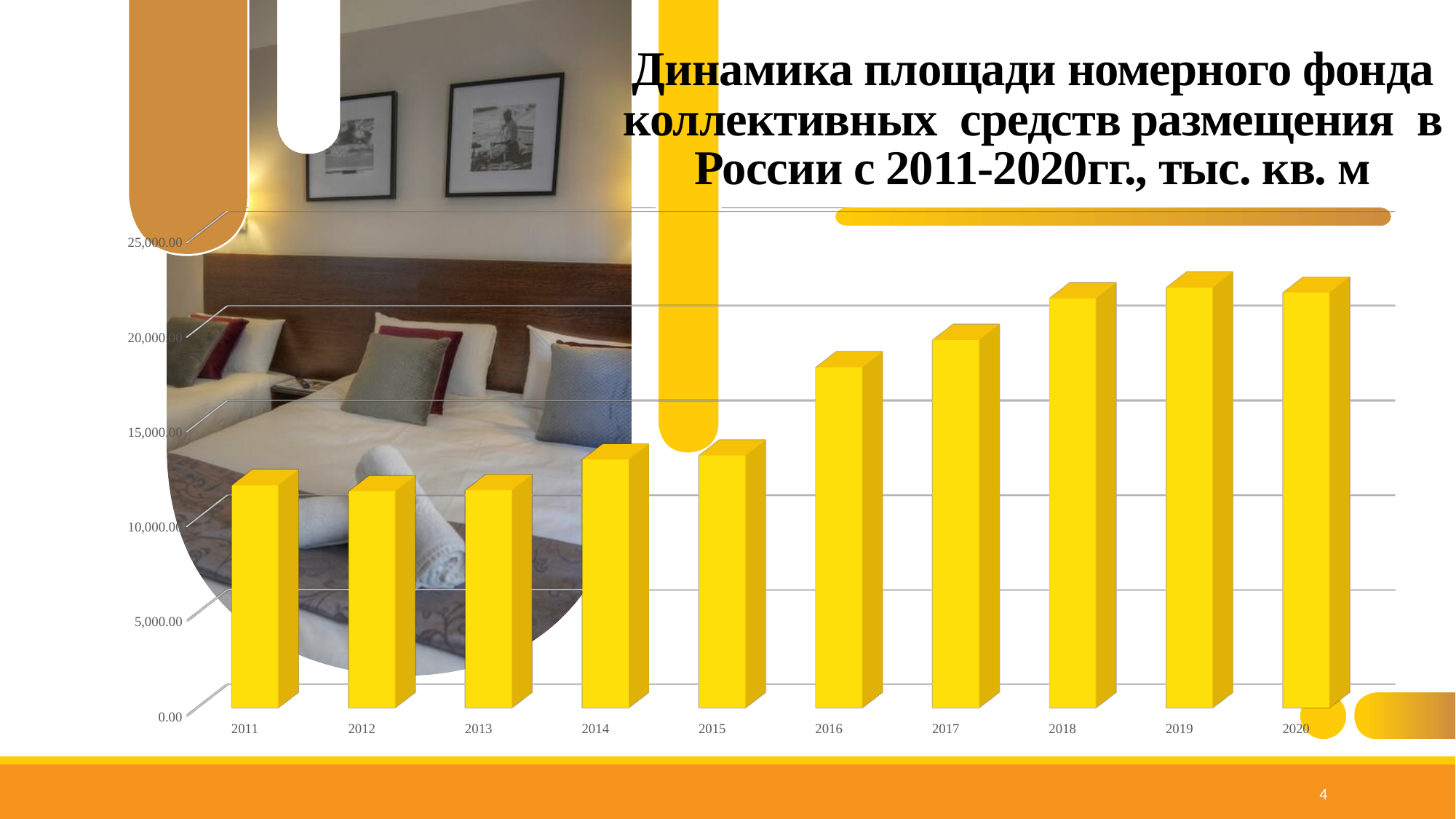
Is the value for 2011 greater or less than 10,000? greater Which year has the larger value, 2011 or 2018? 2018 Is the value for 2014 greater or less than 15,000? less Is the value for 2016 greater or less than 15,000? greater How many years are shown on the x axis of the chart? 10 What is the highest value labelled on the y axis? 25,000.00 What kind of chart is shown on the slide? bar chart Do the values generally rise or fall from 2011 to 2020? rise Which year has the larger value, 2015 or 2016? 2016 What is the first year shown on the x axis? 2011